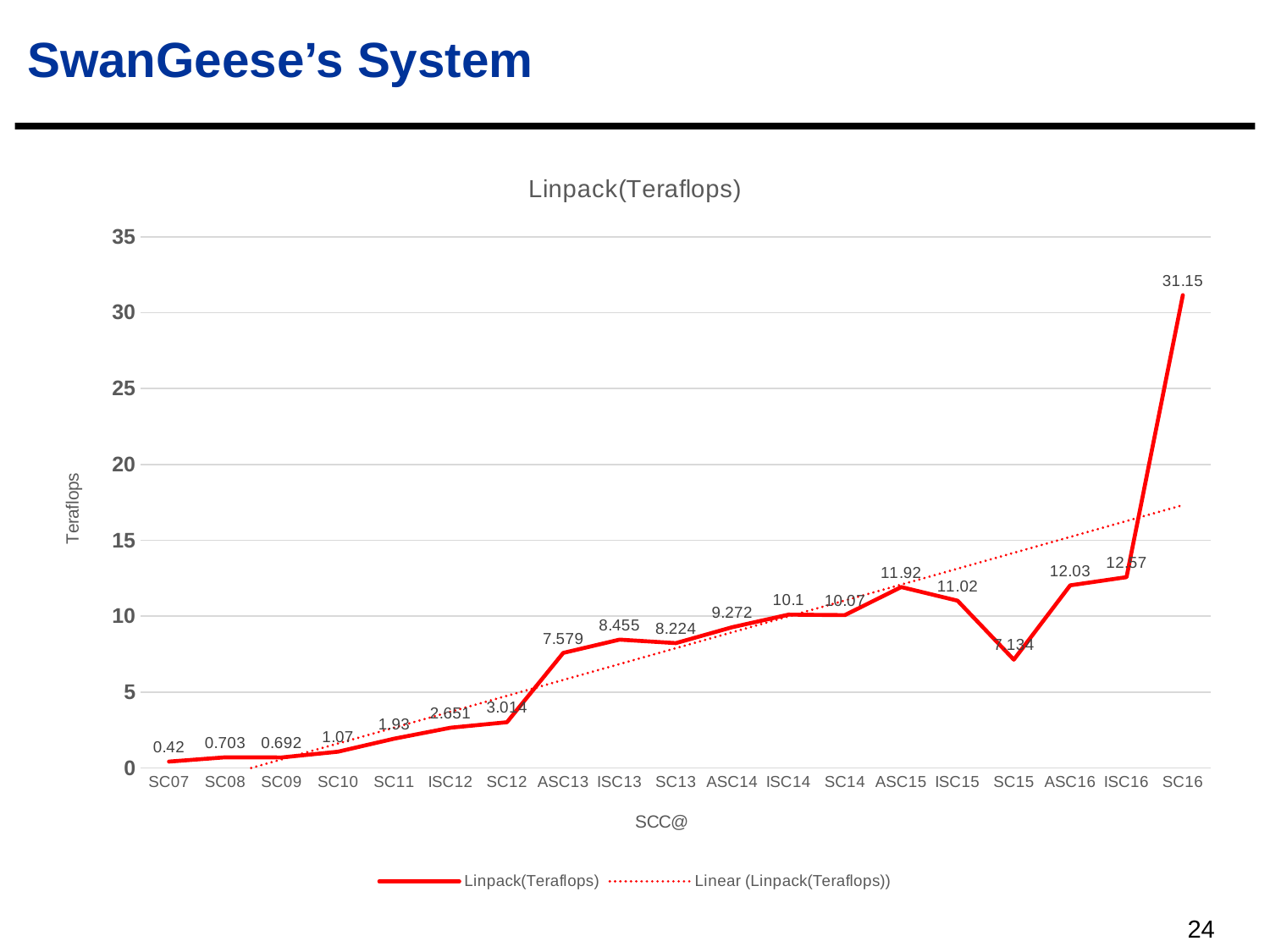
Which category has the highest Linpack value? SC16 How many categories are shown on the x axis? 19 What is the label on the y axis of the chart? Teraflops What kind of chart is shown on the slide? line chart Which category has the lowest Linpack value? SC07 What is the Linpack value for SC16? 31.15 What is the Linpack value for ASC13? 7.579 Is the Linpack value for SC16 greater or less than 30? greater How many series does the legend list? 2 What is the difference between the Linpack values for SC16 and ASC16? 19.12 What is the Linpack value for SC07? 0.42 Which has a larger Linpack value, ISC13 or SC13? ISC13